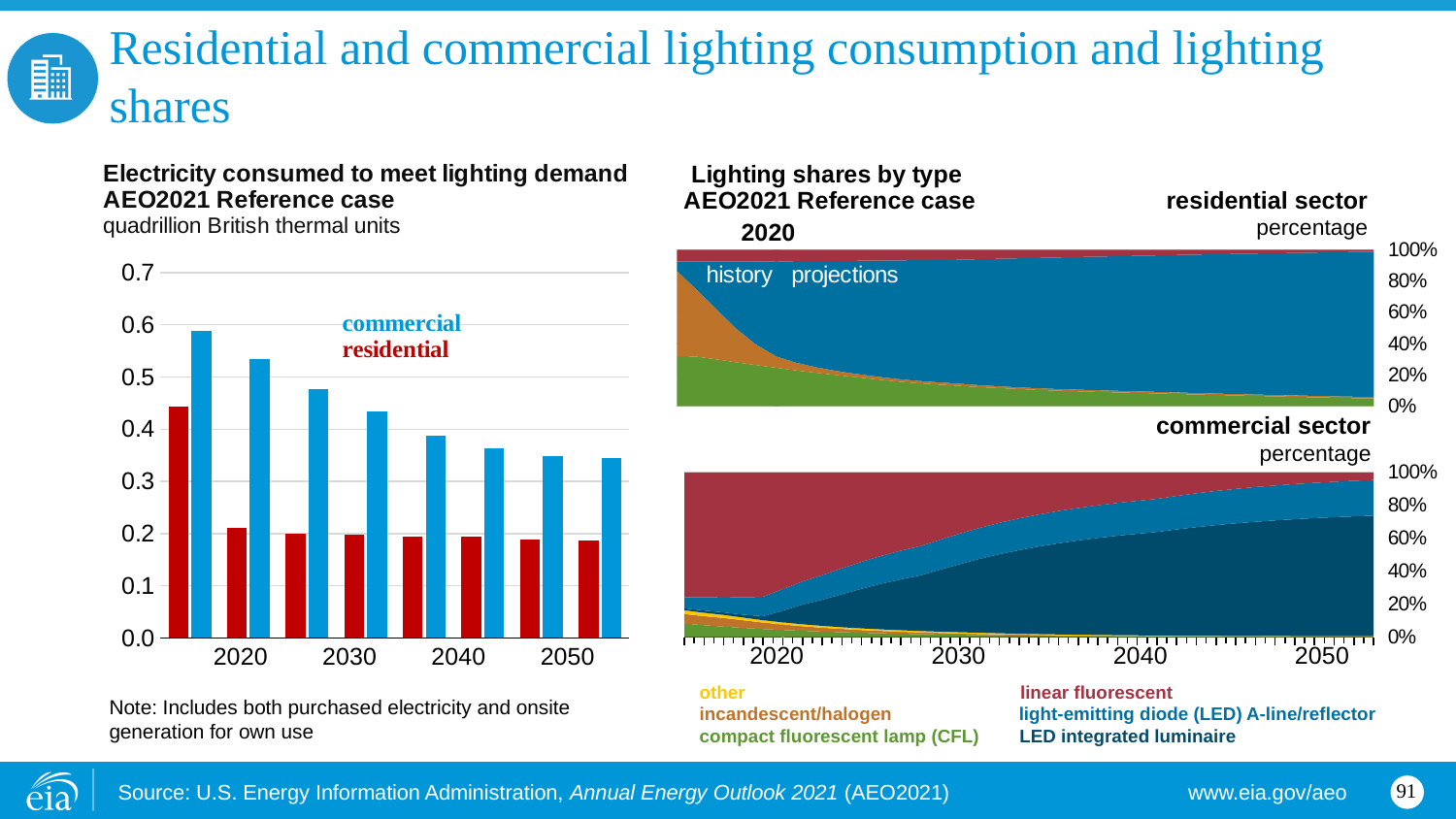
In the 'Electricity consumed to meet lighting demand' chart, how many series are shown? 2 In the 'Lighting shares by type' commercial sector chart, does the share of linear fluorescent rise or fall from 2020 to 2050? fall How many lighting types does the legend list for the 'Lighting shares by type' charts? 6 In the 'Electricity consumed to meet lighting demand' chart, is the commercial value for 2050 greater or less than 0.4? less In the 'Electricity consumed to meet lighting demand' chart, which series is shown in blue? commercial In the 'Electricity consumed to meet lighting demand' chart, which is larger in 2050, commercial or residential? commercial In the 'Electricity consumed to meet lighting demand' chart, is the commercial value for 2020 greater or less than 0.5? greater In the 'Lighting shares by type' residential sector chart, is the share of light-emitting diode (LED) A-line/reflector in 2050 greater or less than 80%? greater In the 'Electricity consumed to meet lighting demand' chart, does commercial lighting consumption rise or fall from 2020 to 2050? fall In the 'Electricity consumed to meet lighting demand' chart, what unit is shown on the y axis? quadrillion British thermal units What kind of chart is the 'Electricity consumed to meet lighting demand' chart on the left? bar chart